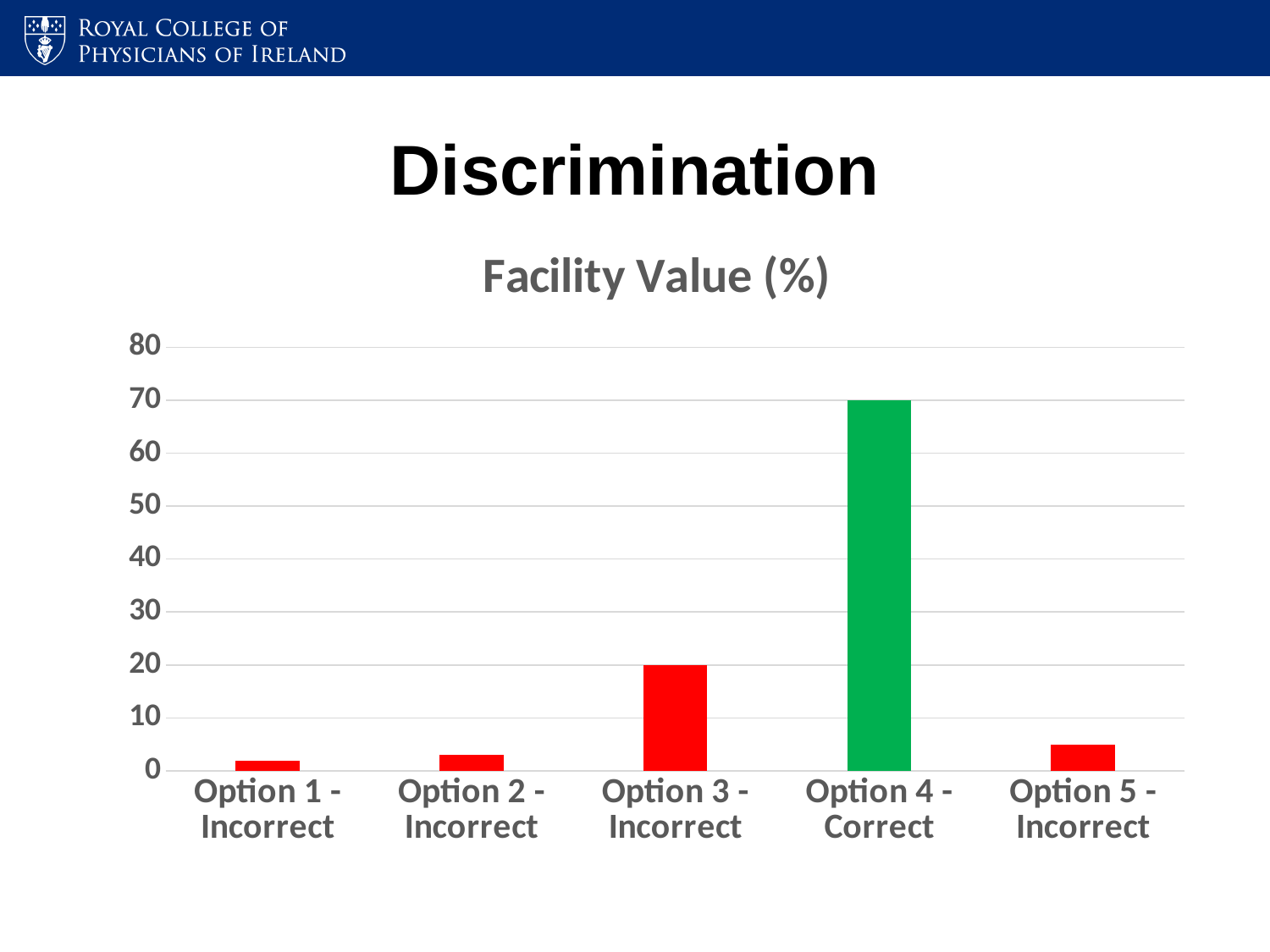
Which option has the highest facility value? Option 4 - Correct How many options (categories) are shown on the x axis of the chart? 5 Which has a larger facility value, Option 3 - Incorrect or Option 5 - Incorrect? Option 3 - Incorrect What is the title of the chart? Facility Value (%) Is the facility value for Option 1 - Incorrect greater or less than 10? less What is the difference between the facility values of Option 4 - Correct and Option 3 - Incorrect? 50 Is the facility value for Option 4 - Correct greater or less than 60? greater What is the facility value for Option 3 - Incorrect? 20 What type of chart is shown on the slide? bar chart Is the facility value for Option 5 - Incorrect greater or less than 10? less What is the facility value for Option 4 - Correct? 70 Which bar in the chart is coloured green? Option 4 - Correct